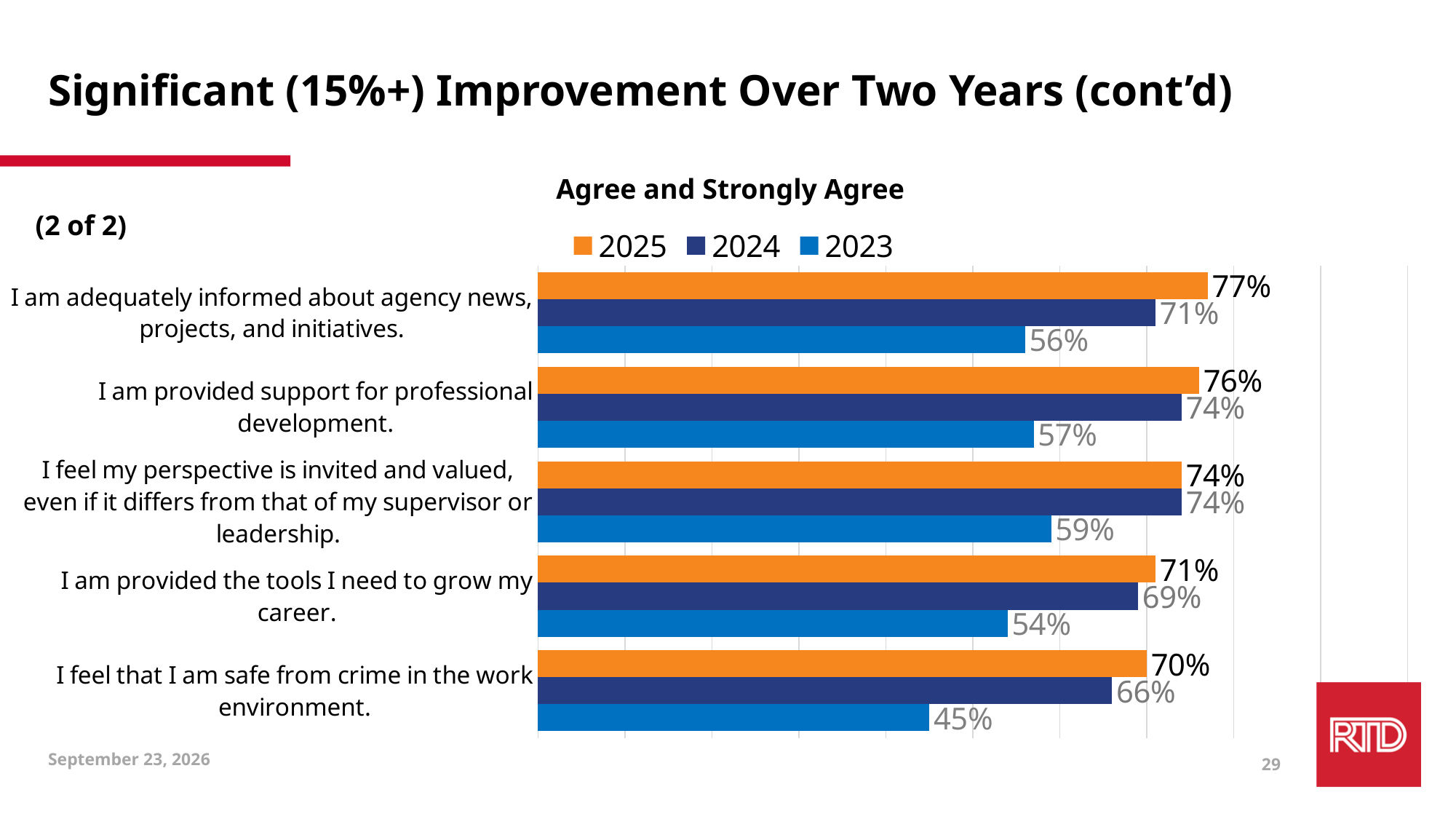
What is the difference between the 2025 and 2023 values for "I am adequately informed about agency news, projects, and initiatives."? 21% Which is larger: the 2024 value for "I am provided support for professional development." or the 2024 value for "I feel that I am safe from crime in the work environment."? I am provided support for professional development. What is the difference between the 2025 and 2023 values for "I feel that I am safe from crime in the work environment."? 25% How many series does the legend list? 3 What is the 2023 value for "I feel that I am safe from crime in the work environment."? 45% What kind of chart is shown on the slide? Bar chart How many statements (categories) are shown in the chart? 5 What is the 2025 value for "I am adequately informed about agency news, projects, and initiatives."? 77% Which statement has the lowest 2023 value? I feel that I am safe from crime in the work environment. Which statement has the highest 2025 value? I am adequately informed about agency news, projects, and initiatives. What is the title of the chart? Agree and Strongly Agree What is the 2024 value for "I am provided the tools I need to grow my career."? 69%